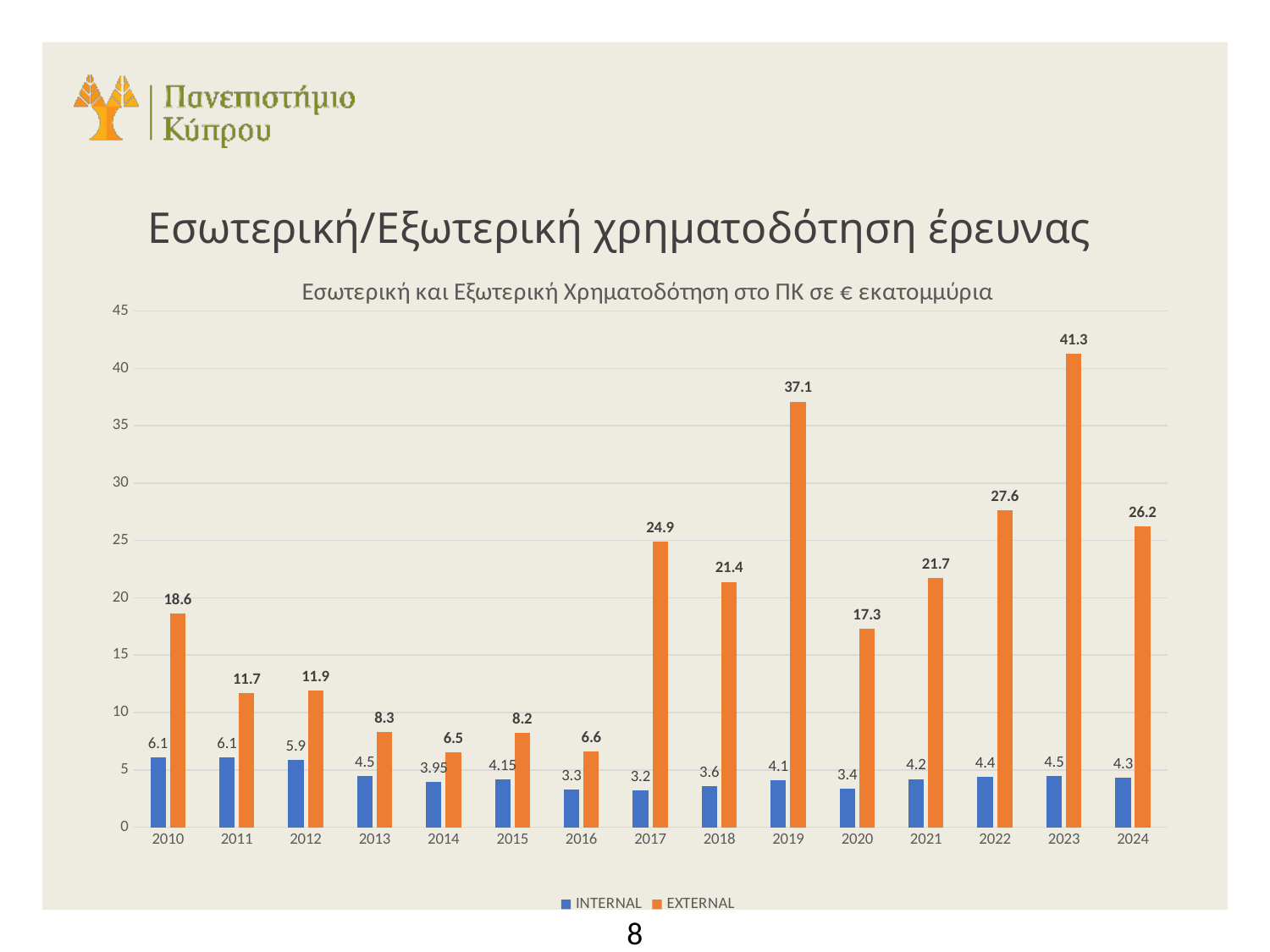
How many series does the legend list? 2 What is the total of the INTERNAL and EXTERNAL values for 2010? 24.7 What is the difference between the EXTERNAL values for 2023 and 2024? 15.1 What is the EXTERNAL value for 2019? 37.1 Which colour represents the EXTERNAL series? orange Which year has the highest EXTERNAL value? 2023 What is the INTERNAL value for 2014? 3.95 Is the EXTERNAL value for 2020 greater or less than 15? greater How many years are shown on the x axis? 15 Which is larger, the EXTERNAL value for 2018 or for 2021? 2021 Which year has the lowest INTERNAL value? 2017 What kind of chart is shown on the slide? bar chart